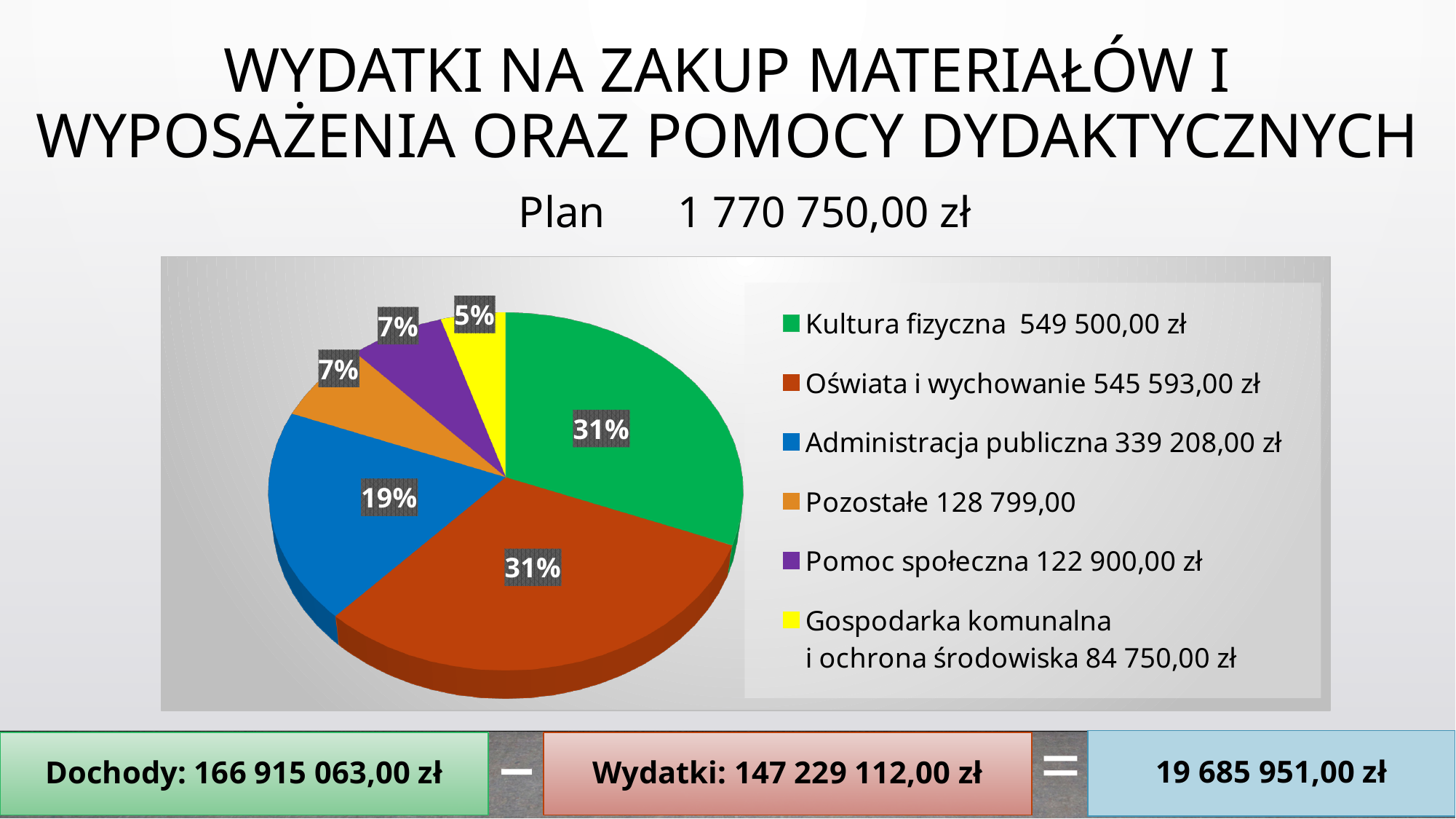
What is the value for Gospodarka komunalna i ochrona środowiska in the legend? 84 750,00 zł How many categories does the pie chart have? 6 What share of the pie does Gospodarka komunalna i ochrona środowiska represent? 5% What is the value for Pomoc społeczna in the legend? 122 900,00 zł Which category has the smallest value in the pie chart? Gospodarka komunalna i ochrona środowiska What is the value for Administracja publiczna in the legend? 339 208,00 zł What share of the pie does Administracja publiczna represent? 19% What is the difference between the values for Kultura fizyczna and Oświata i wychowanie? 3 907,00 zł What kind of chart is shown on the slide? pie chart What is the value for Kultura fizyczna in the legend? 549 500,00 zł Which is larger, the value for Pozostałe or the value for Pomoc społeczna? Pozostałe Which category has the largest value in the pie chart? Kultura fizyczna